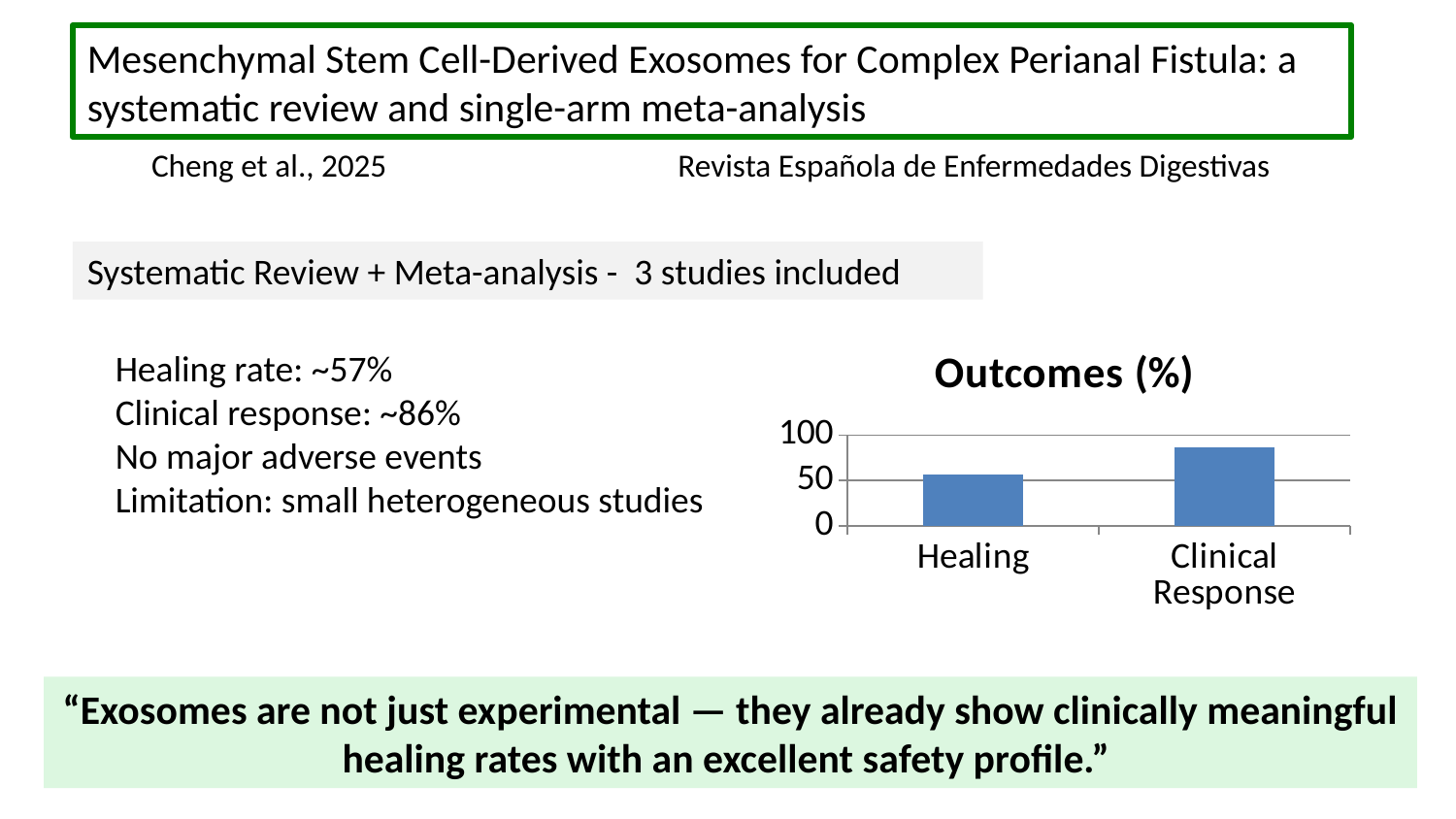
What is the title of the chart? Outcomes (%) What kind of chart is shown on the slide? bar chart Which category has the lowest bar in the chart? Healing Which is larger in the chart, the value for Healing or the value for Clinical Response? Clinical Response Do the bar values rise or fall from Healing to Clinical Response? rise Is the value for Clinical Response greater or less than 50? greater Is the value for Healing greater or less than 100? less Is the value for Healing greater or less than 50? greater Which category has the highest bar in the chart? Clinical Response How many categories are plotted in the chart? 2 What is the highest value shown on the chart's vertical axis? 100